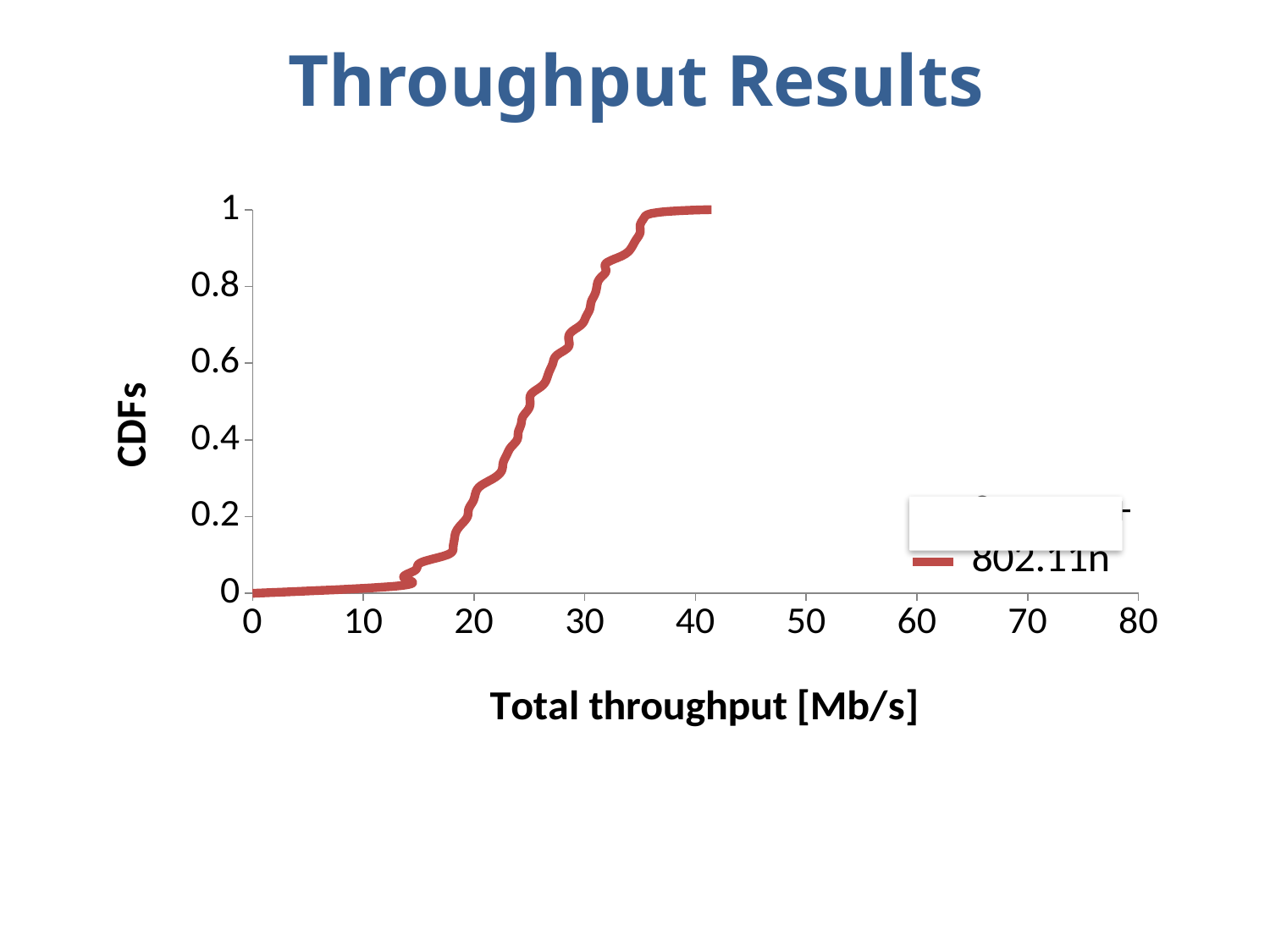
What is the label of the x axis? Total throughput [Mb/s] Does the 802.11n curve rise or fall as total throughput increases along the x axis? rise Is the CDF value for 802.11n larger at 25 Mb/s or at 15 Mb/s? 25 Mb/s Is the CDF value for 802.11n at 40 Mb/s greater or less than 0.8? greater What is the highest CDF value the 802.11n curve reaches? 1 What is the largest value shown on the x axis? 80 What is the title of the chart on the slide? Throughput Results Is the CDF value for 802.11n at 20 Mb/s greater or less than 0.6? less Is the CDF value for 802.11n at 30 Mb/s greater or less than 0.6? greater Which series is drawn as the red line in the legend? 802.11n What kind of chart is shown on the slide? line chart